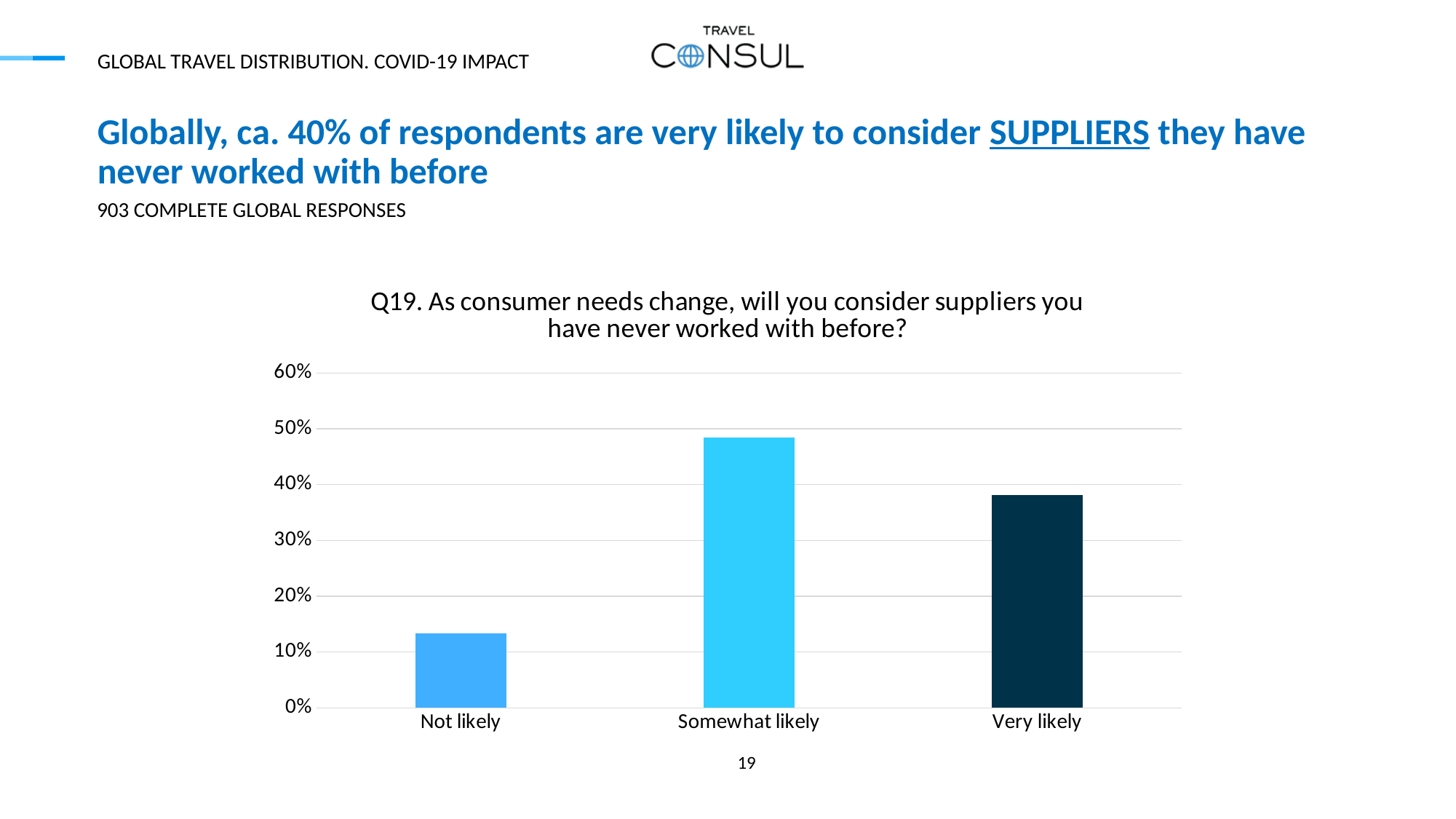
What kind of chart is shown on the slide? bar chart Is the value for Very likely greater or less than 30%? greater Which is larger, the value for Somewhat likely or the value for Very likely? Somewhat likely Which category has the highest value in the chart? Somewhat likely Is the value for Somewhat likely greater or less than 50%? less What is the title of the chart? Q19. As consumer needs change, will you consider suppliers you have never worked with before? What is the highest value shown on the chart's y axis? 60% Which is larger, the value for Very likely or the value for Not likely? Very likely Is the value for Not likely greater or less than 20%? less Which category has the lowest value in the chart? Not likely How many categories are shown on the x axis of the chart? 3